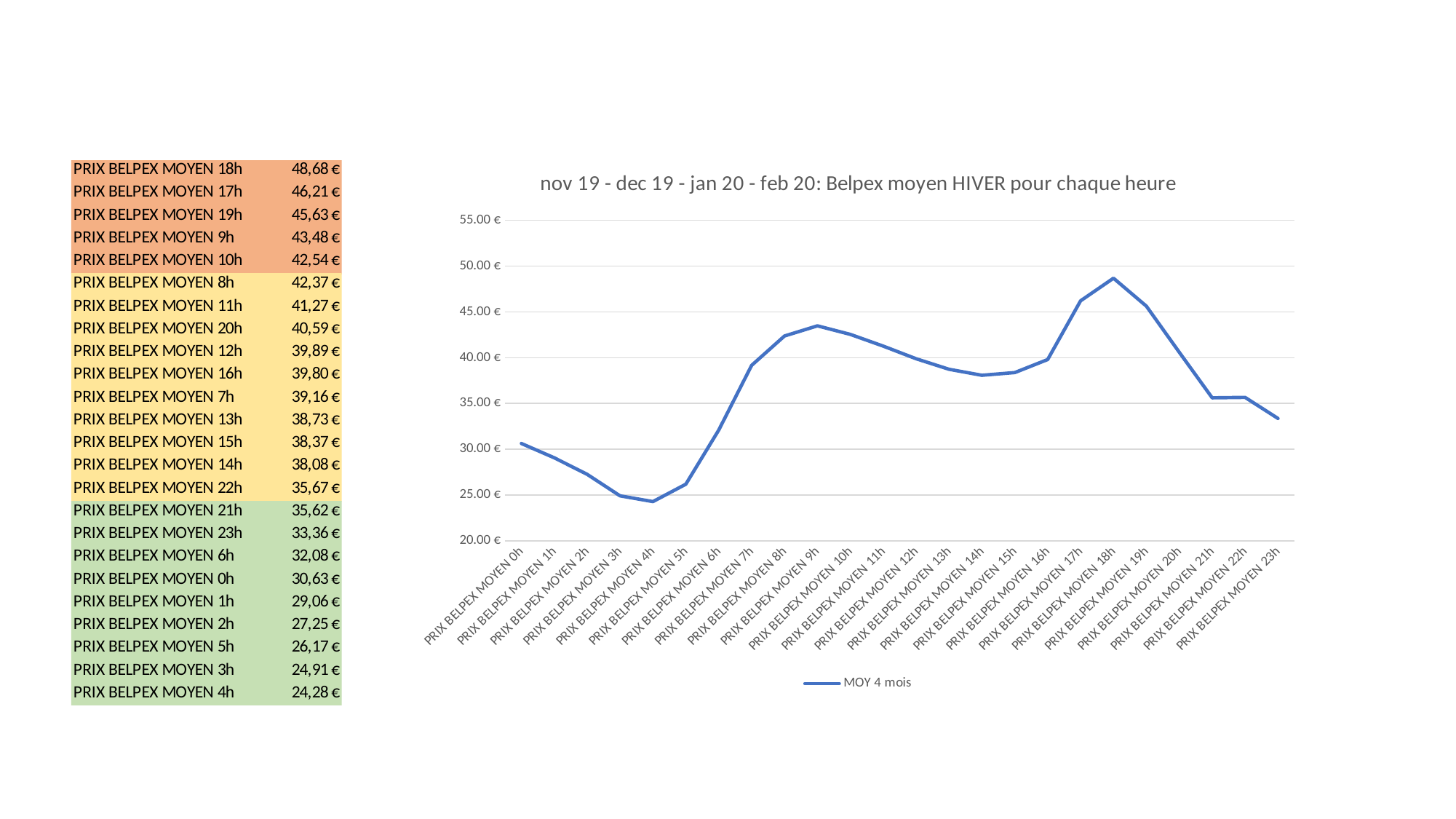
Which is larger on the chart, the value for PRIX BELPEX MOYEN 17h or PRIX BELPEX MOYEN 12h? PRIX BELPEX MOYEN 17h Is the value for PRIX BELPEX MOYEN 3h on the chart greater or less than 30.00 €? less Is the value for PRIX BELPEX MOYEN 9h on the chart greater or less than 40.00 €? greater According to the table on the slide, what is the value for PRIX BELPEX MOYEN 18h? 48,68 € According to the table on the slide, what is the value for PRIX BELPEX MOYEN 4h? 24,28 € How many series does the chart legend list? 1 What type of chart is shown on the slide? line chart Which hour has the lowest value on the chart? PRIX BELPEX MOYEN 4h Using the values in the table, what is the difference between PRIX BELPEX MOYEN 18h and PRIX BELPEX MOYEN 4h? 24,40 € Which hour has the highest value on the chart? PRIX BELPEX MOYEN 18h How many hourly points are plotted on the chart? 24 What is the name of the series in the chart legend? MOY 4 mois